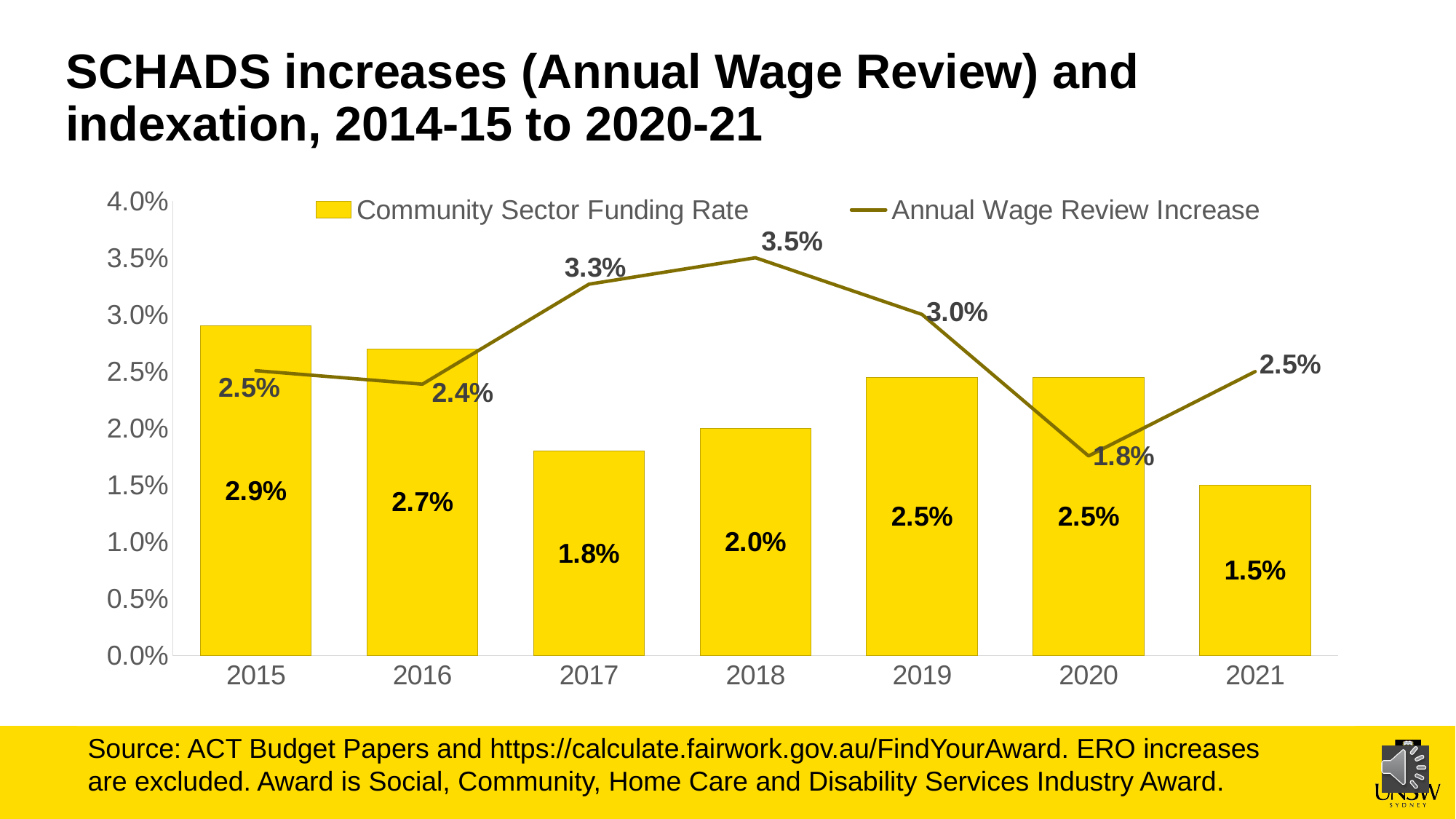
What kind of chart is shown on the slide? Combined bar and line chart In which year is the Annual Wage Review Increase highest? 2018 What is the Annual Wage Review Increase for 2018? 3.5% What is the Community Sector Funding Rate for 2021? 1.5% How many years are shown on the x axis? 7 Does the Community Sector Funding Rate rise or fall from 2015 to 2017? Fall In which year is the Community Sector Funding Rate lowest? 2021 What is the Annual Wage Review Increase for 2020? 1.8% What is the difference between the Annual Wage Review Increase and the Community Sector Funding Rate in 2017? 1.5% How many series does the legend list? 2 In 2020, which is larger: the Community Sector Funding Rate or the Annual Wage Review Increase? Community Sector Funding Rate What is the Community Sector Funding Rate for 2015? 2.9%